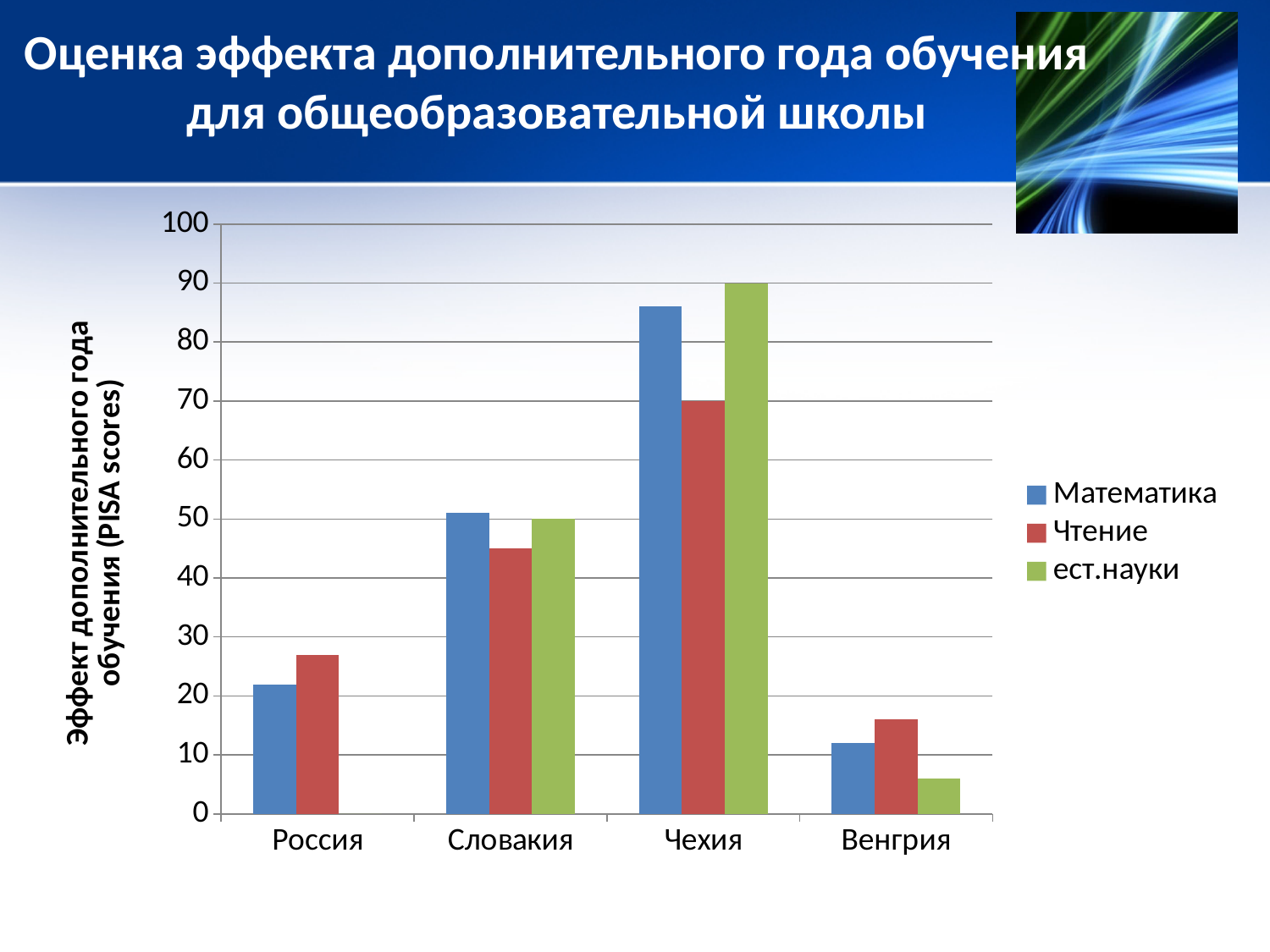
Which is larger in Венгрия: Чтение or ест.науки? Чтение What is the value for ест.науки in Словакия? 50 How many countries are shown on the x axis? 4 Is the value for Математика in Россия greater or less than 30? less Which country has the highest value for Математика? Чехия What kind of chart is shown on the slide? bar chart What is the value for ест.науки in Чехия? 90 What is the label of the vertical axis? Эффект дополнительного года обучения (PISA scores) How many series does the legend list? 3 What is the value for Чтение in Чехия? 70 Is the value for Математика in Чехия greater or less than 80? greater